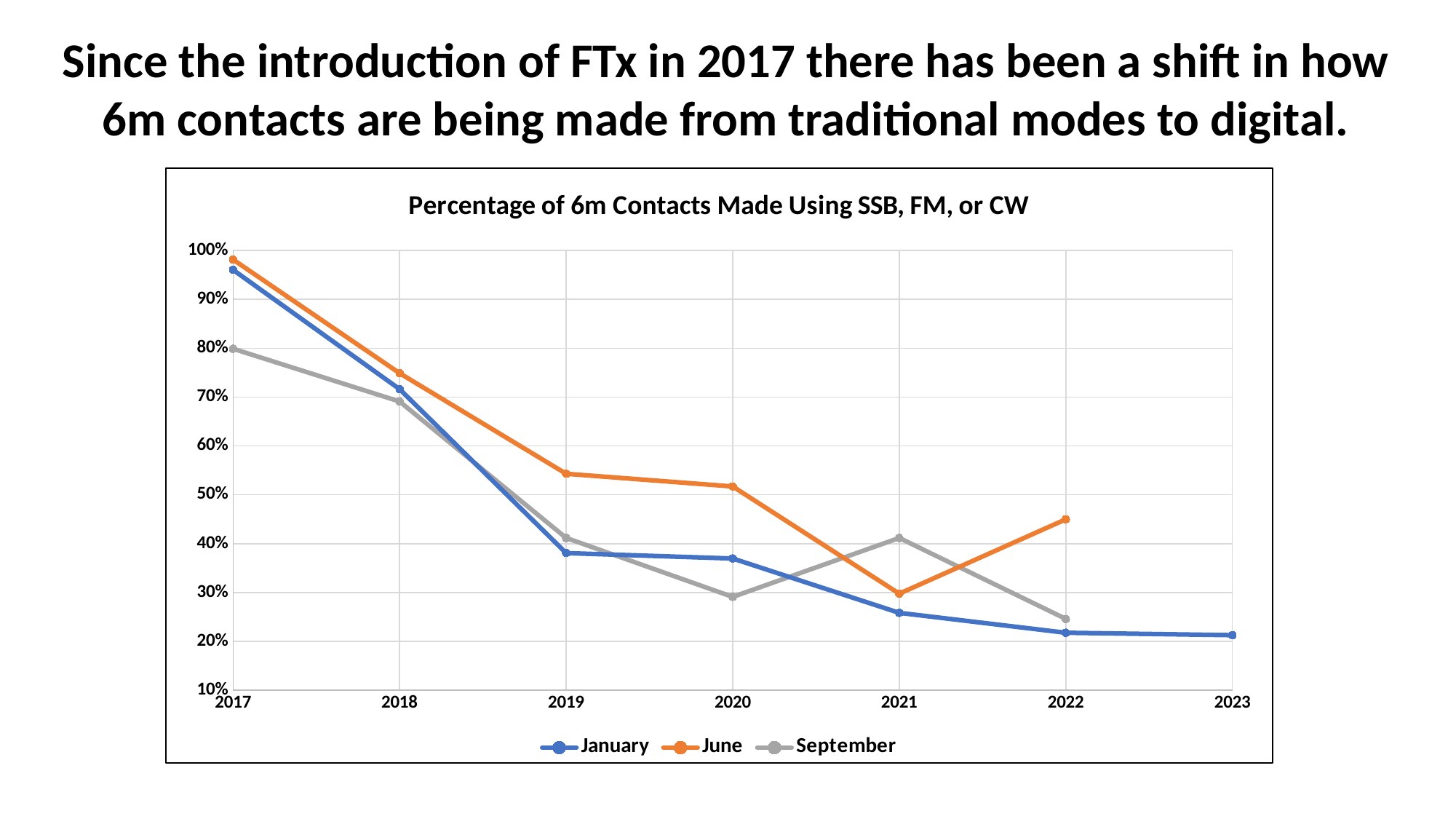
Which series has the highest value in 2022? June Which series has the lowest value in 2017? September Is the value for September in 2017 greater or less than 90%? less Is the value for June in 2019 greater or less than 50%? greater How many series does the legend list? 3 In 2020, which is larger: the value for June or the value for September? June Is the value for January in 2021 greater or less than 30%? less What kind of chart is shown on the slide? line chart Does the January series rise or fall from 2017 to 2023? fall How many years are shown on the x axis? 7 What is the title of the chart? Percentage of 6m Contacts Made Using SSB, FM, or CW Which series is shown in orange? June